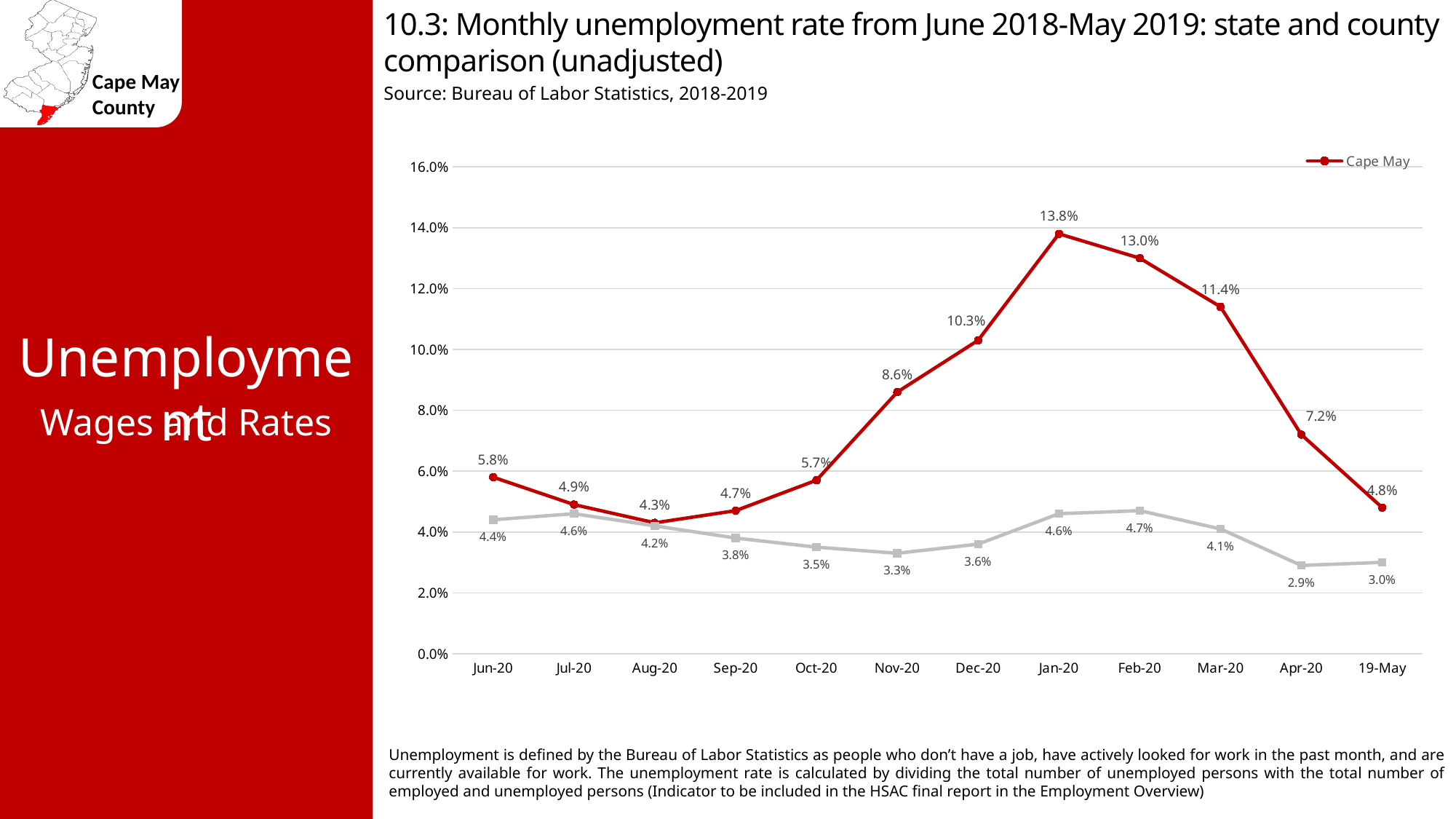
Is the Cape May value for Mar-20 greater or less than 10.0%? greater What is the Cape May unemployment rate for Jan-20? 13.8% What kind of chart is shown on the slide? line chart How many months are shown on the x axis? 12 Does the Cape May rate rise or fall from Jan-20 to 19-May? fall In which month is the Cape May unemployment rate lowest? Aug-20 What is the Cape May unemployment rate for Nov-20? 8.6% In which month is the Cape May unemployment rate highest? Jan-20 By how many percentage points does the Cape May rate fall from Jan-20 to Feb-20? 0.8 percentage points What is the value of the gray line at Apr-20? 2.9% Which month has the higher Cape May rate, Dec-20 or Mar-20? Mar-20 How many series does the legend list? 1